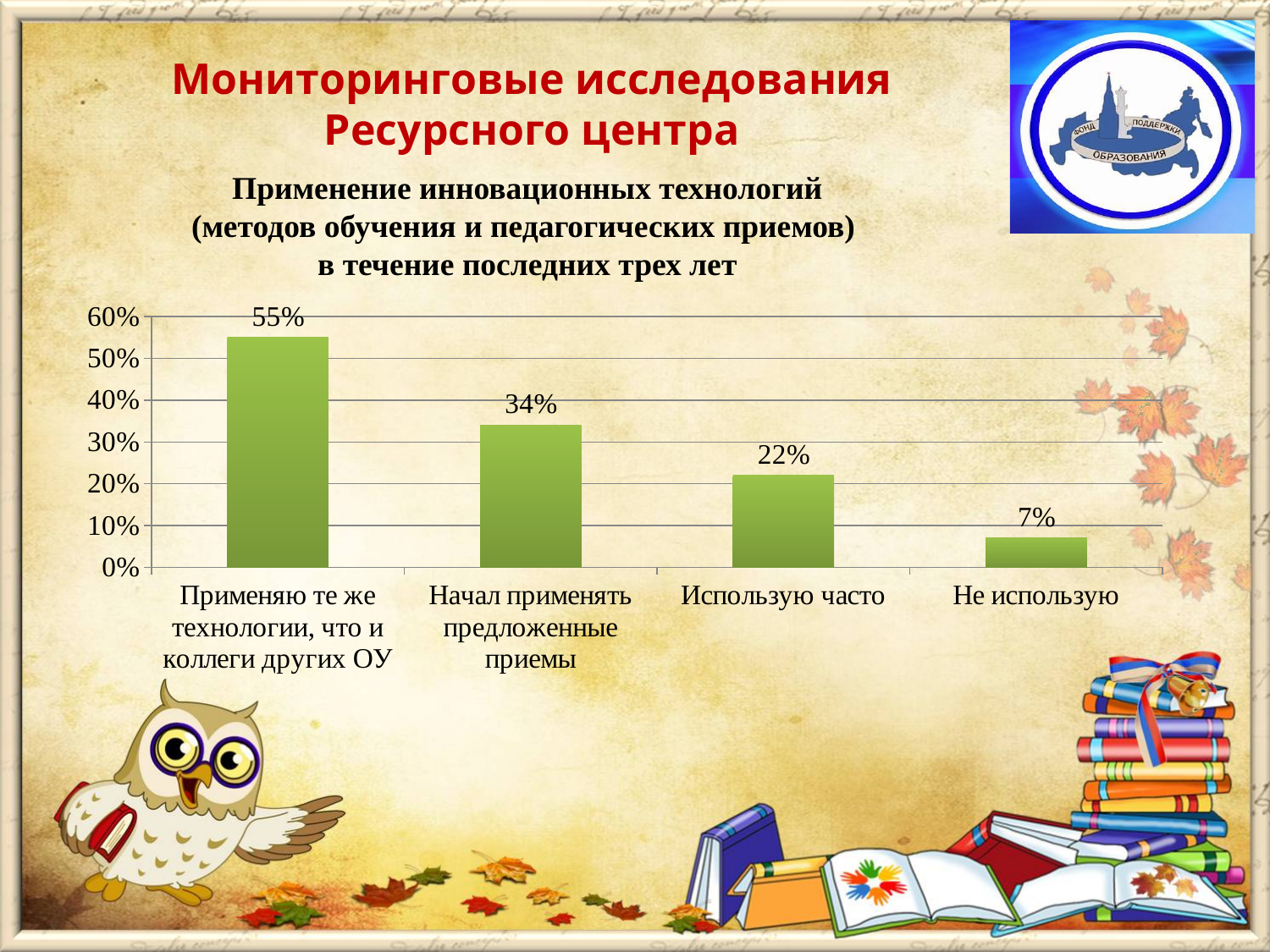
What is the value for "Применяю те же технологии, что и коллеги других ОУ"? 55% How many categories are shown on the chart? 4 Which category has the lowest value? Не использую What is the value for "Использую часто"? 22% What is the difference between the values for "Применяю те же технологии, что и коллеги других ОУ" and "Начал применять предложенные приемы"? 21% What is the value for "Начал применять предложенные приемы"? 34% What kind of chart is shown on the slide? bar chart Which category has the highest value? Применяю те же технологии, что и коллеги других ОУ Do the values rise or fall from left to right along the x axis? fall Which is larger: the value for "Использую часто" or the value for "Не использую"? Использую часто Is the value for "Начал применять предложенные приемы" greater or less than 30%? greater What is the value for "Не использую"? 7%